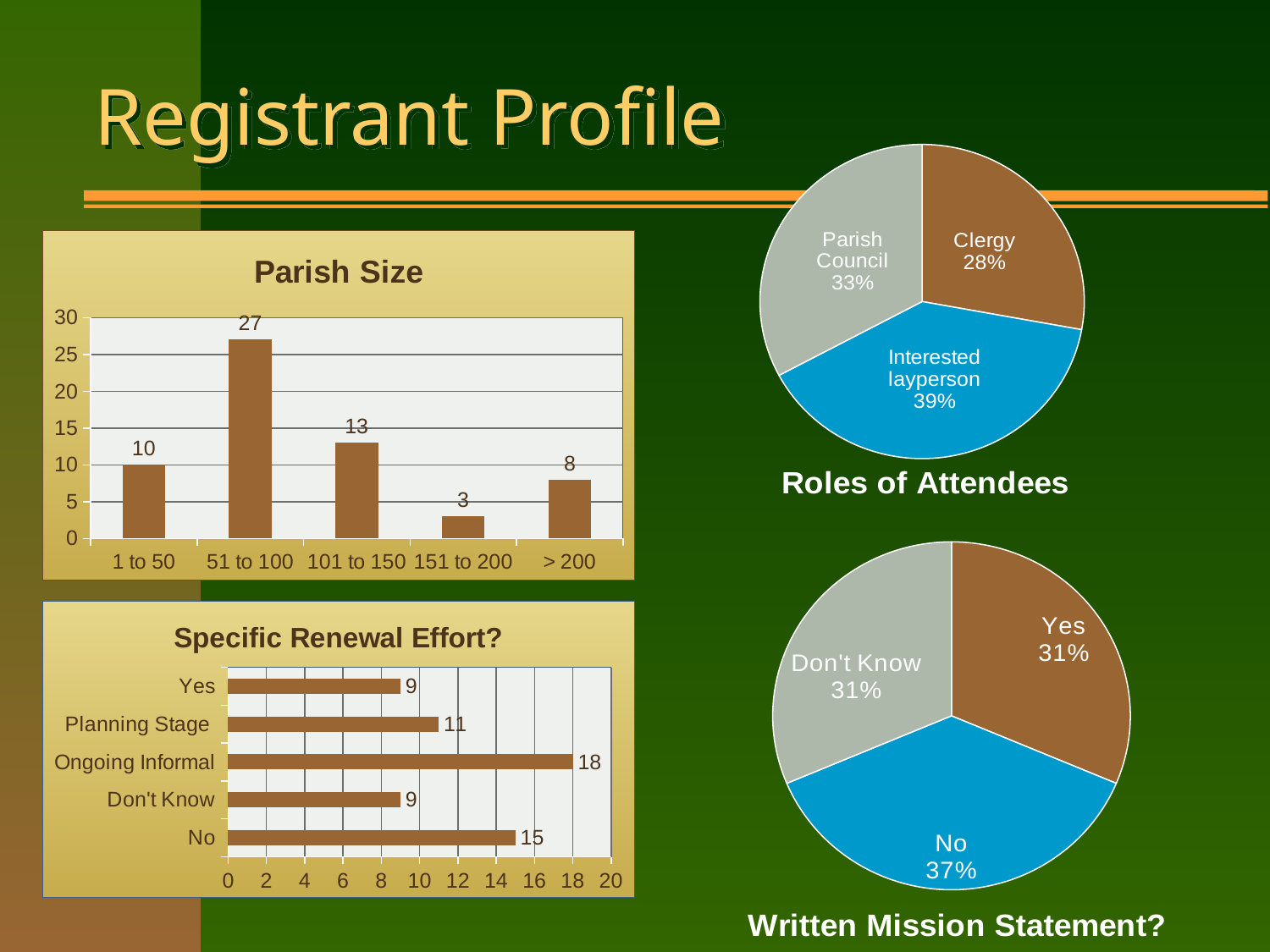
In the Parish Size chart, what is the value for 51 to 100? 27 In the Roles of Attendees pie chart, what share is Interested layperson? 39% In the Parish Size chart, what is the difference between the values for 51 to 100 and 101 to 150? 14 In the Roles of Attendees pie chart, which slice is the smallest? Clergy What kind of chart is the Specific Renewal Effort? chart? Bar chart In the Written Mission Statement? pie chart, what share is No? 37% In the Specific Renewal Effort? chart, what is the value for Ongoing Informal? 18 In the Parish Size chart, is the value for 1 to 50 greater or less than the value for > 200? greater In the Parish Size chart, which category has the lowest value? 151 to 200 In the Specific Renewal Effort? chart, what is the difference between the values for No and Planning Stage? 4 In the Parish Size chart, how many categories are shown on the x axis? 5 In the Specific Renewal Effort? chart, which category has the highest value? Ongoing Informal